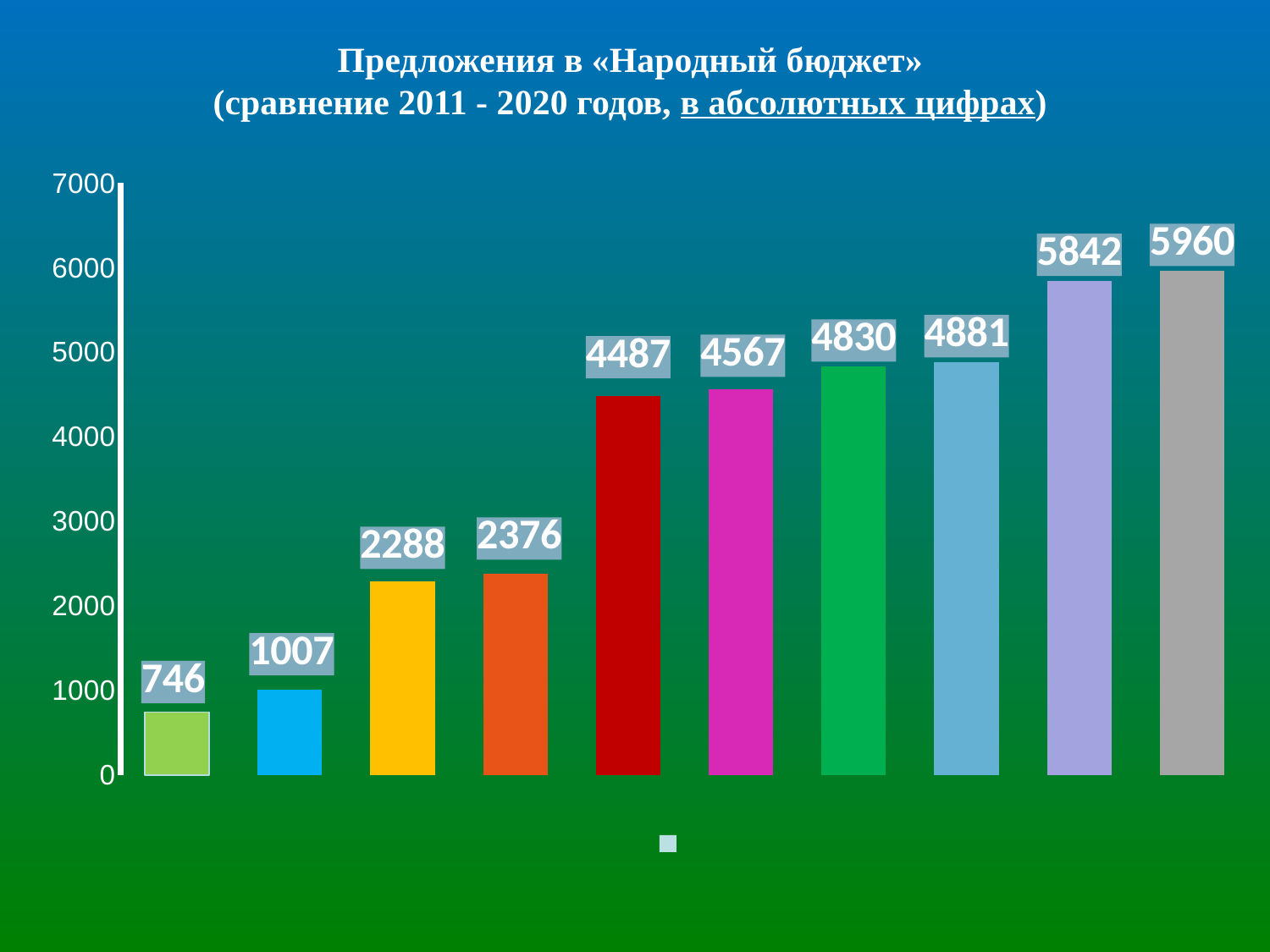
What is the value of the rightmost bar? 5960 What is the value of the leftmost bar? 746 What type of chart is shown on the slide? bar chart What is the difference between the second bar (1007) and the first bar (746)? 261 What is the title of the chart? Предложения в «Народный бюджет» (сравнение 2011 - 2020 годов, в абсолютных цифрах) What is the difference between the highest and lowest values in the chart? 5214 What is the lowest value shown in the chart? 746 What is the highest value shown in the chart? 5960 Do the values generally rise or fall from left to right across the chart? rise Which is larger, the value of the third bar or the fourth bar from the left? the fourth bar (2376) How many bars are plotted in the chart? 10 What is the value of the third bar from the left? 2288